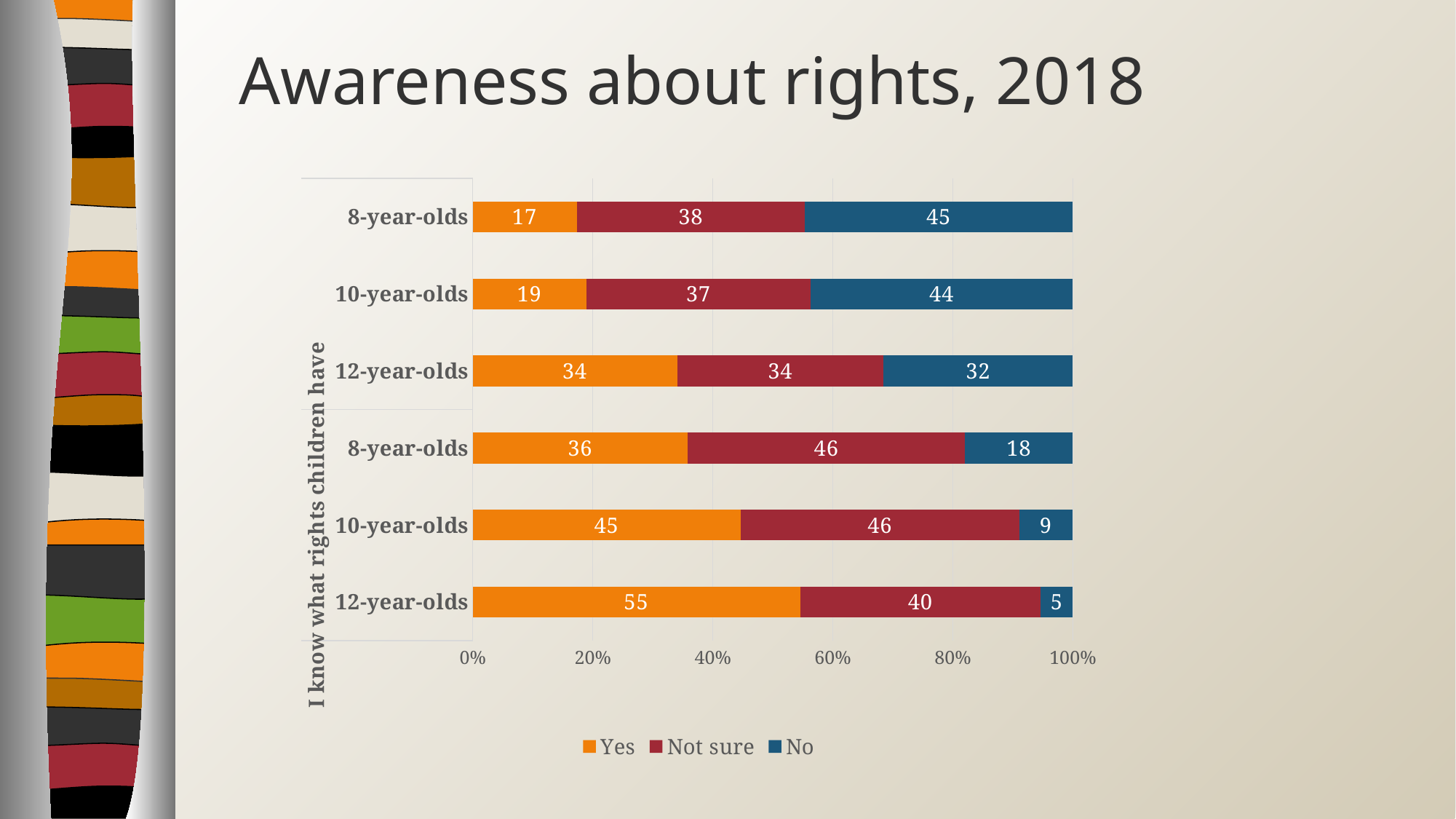
In the topmost group of three bars, is the 'No' value larger for 8-year-olds or for 12-year-olds? 8-year-olds In the 'I know what rights children have' group, what is the 'No' value for 10-year-olds? 9 What are the three series named in the legend? Yes, Not sure, No In the topmost group of three bars, which age group has the lowest 'Yes' value? 8-year-olds How many series does the legend list? 3 In the 'I know what rights children have' group, which age group has the highest 'Yes' value? 12-year-olds What kind of chart is shown on the slide? stacked bar chart How many bars are plotted in the chart? 6 In the topmost bar (8-year-olds), what is the 'Not sure' value? 38 In the topmost group of three bars, what is the 'No' value for 10-year-olds? 44 In the 'I know what rights children have' group, what is the 'Yes' value for 12-year-olds? 55 In the 'I know what rights children have' group, what is the difference between the 'Yes' values for 12-year-olds and 8-year-olds? 19